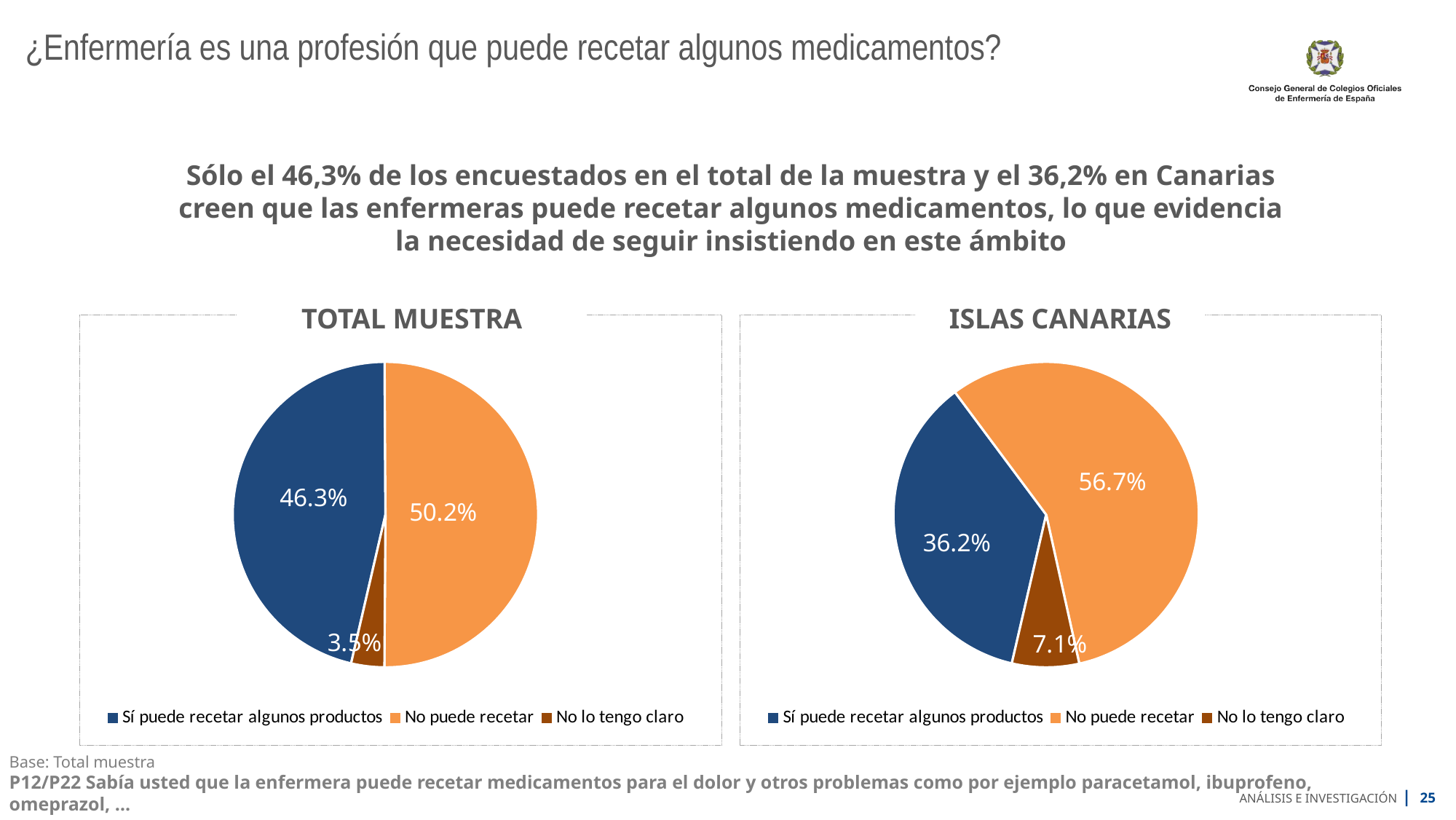
In the TOTAL MUESTRA chart, what percentage corresponds to 'No lo tengo claro'? 3.5% Which is larger: the 'Sí puede recetar algunos productos' share in the TOTAL MUESTRA chart or in the ISLAS CANARIAS chart? TOTAL MUESTRA What is the difference between the 'No puede recetar' share in the ISLAS CANARIAS chart and in the TOTAL MUESTRA chart? 6.5% In the ISLAS CANARIAS chart, what percentage corresponds to 'No puede recetar'? 56.7% In the TOTAL MUESTRA chart, what percentage corresponds to 'Sí puede recetar algunos productos'? 46.3% What type of chart is used for TOTAL MUESTRA? Pie chart How many categories does the legend of the ISLAS CANARIAS chart list? 3 In the ISLAS CANARIAS chart, which category has the largest share? No puede recetar In the TOTAL MUESTRA chart, what percentage corresponds to 'No puede recetar'? 50.2% In the ISLAS CANARIAS chart, what percentage corresponds to 'No lo tengo claro'? 7.1% In the ISLAS CANARIAS chart, what percentage corresponds to 'Sí puede recetar algunos productos'? 36.2% In the TOTAL MUESTRA chart, which category has the smallest share? No lo tengo claro